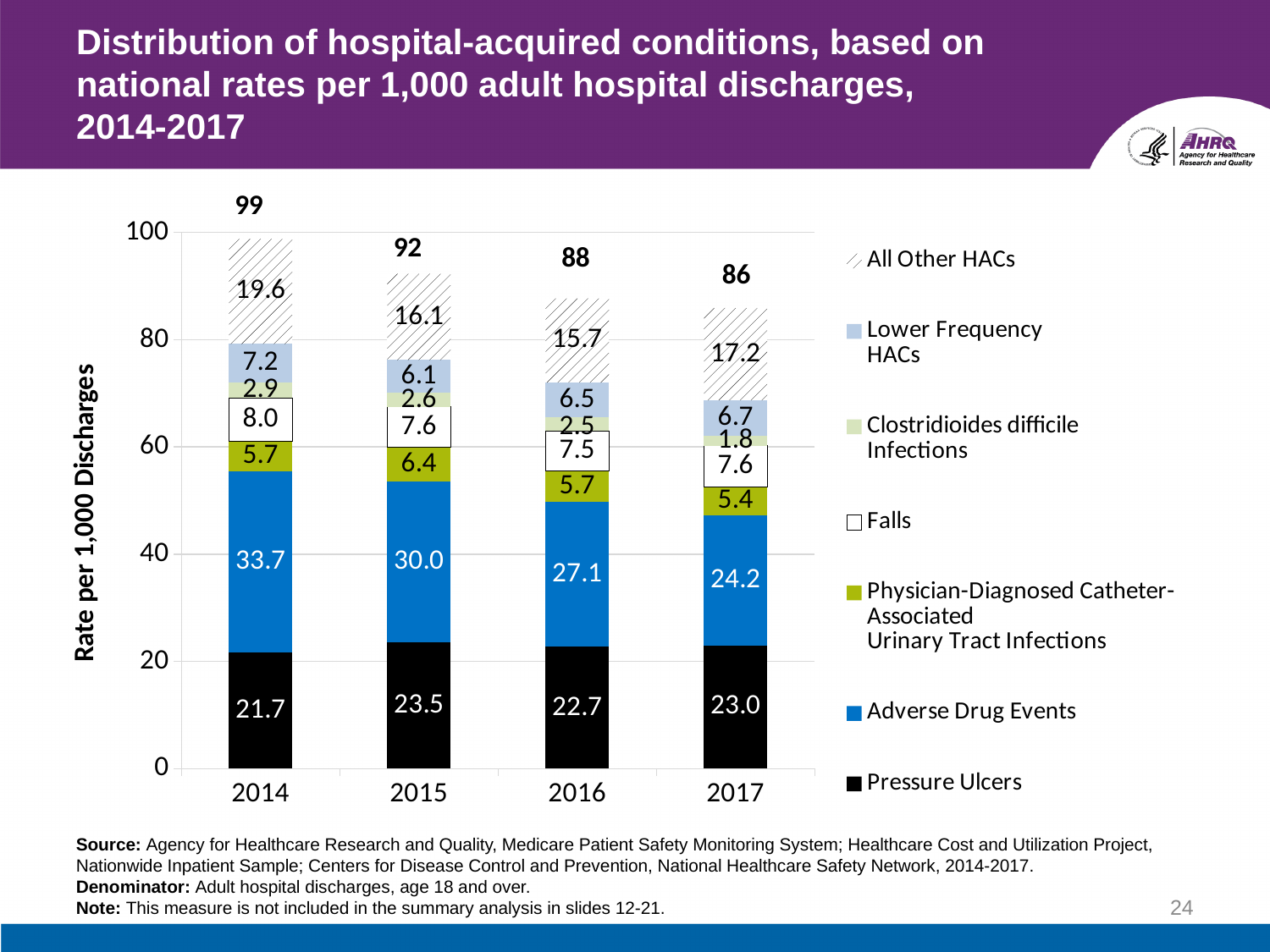
What is the difference between the Adverse Drug Events values for 2014 and 2017? 9.5 How many years are shown on the x axis? 4 What kind of chart is shown on the slide? Stacked bar chart Which is larger, the Pressure Ulcers value in 2015 or in 2014? 2015 Which year has the highest total rate? 2014 Do the total rates rise or fall from 2014 to 2017? Fall Which year has the lowest total rate? 2017 How many series does the legend list? 7 What is the value for All Other HACs in 2017? 17.2 What is the value for Falls in 2016? 7.5 What is the value for Adverse Drug Events in 2014? 33.7 What is the total of the stacked bar for 2015? 92